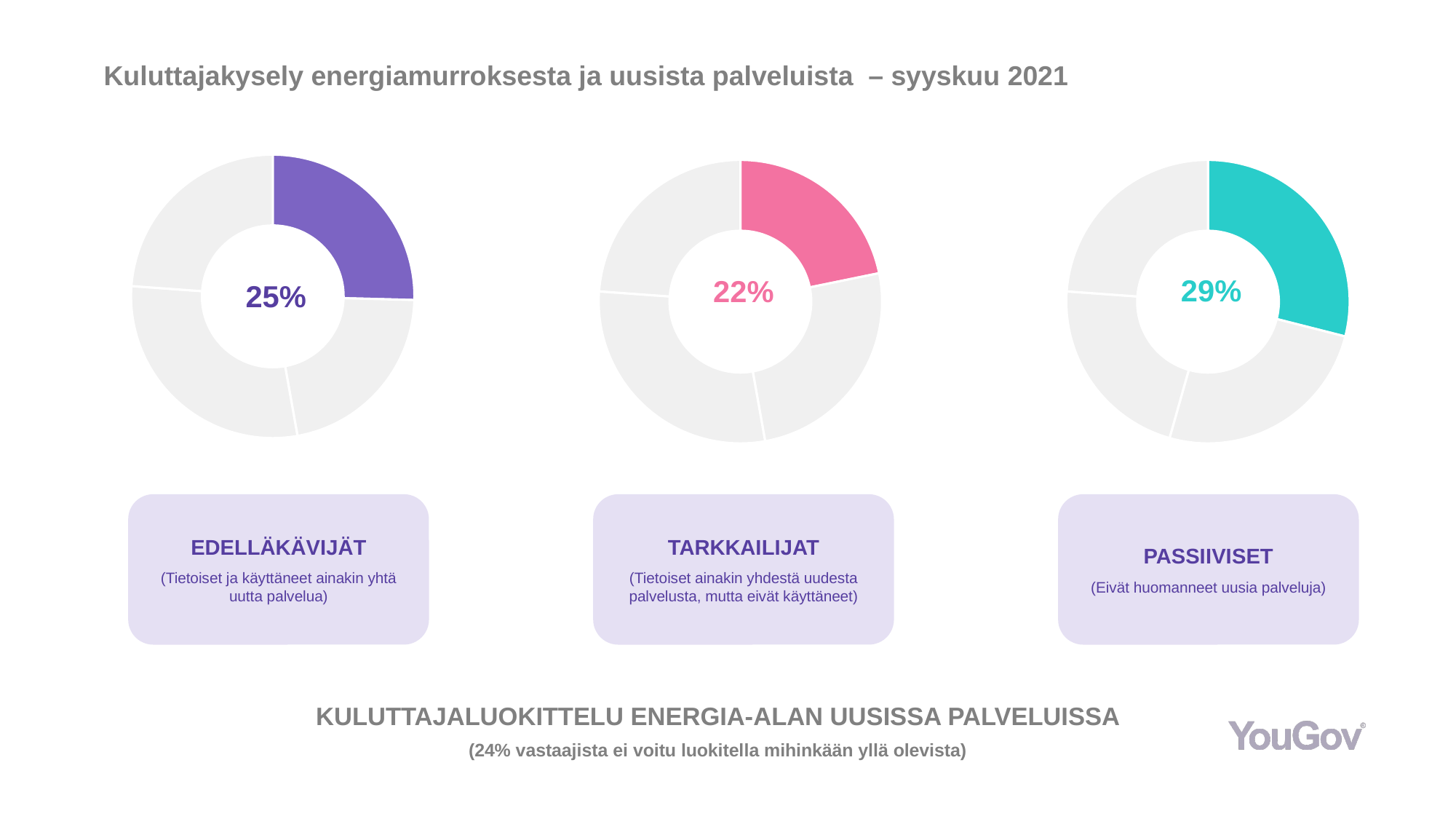
What is the difference between the Edelläkävijät percentage and the Tarkkailijat percentage? 3% Across the three donut charts, which group has the highest percentage? Passiiviset What kind of chart is used to show the Edelläkävijät share? Donut (pie) chart What colour is the highlighted segment in the Tarkkailijat donut chart? Pink According to the note at the bottom of the slide, what percentage of respondents could not be classified into any of the groups? 24% What percentage is shown in the Edelläkävijät donut chart? 25% Which is larger, the Edelläkävijät percentage or the Passiiviset percentage? Passiiviset What is the difference between the Passiiviset percentage and the Tarkkailijat percentage? 7% How many donut charts are shown on the slide? 3 What percentage is shown in the Tarkkailijat donut chart? 22% Across the three donut charts, which group has the lowest percentage? Tarkkailijat What percentage is shown in the Passiiviset donut chart? 29%